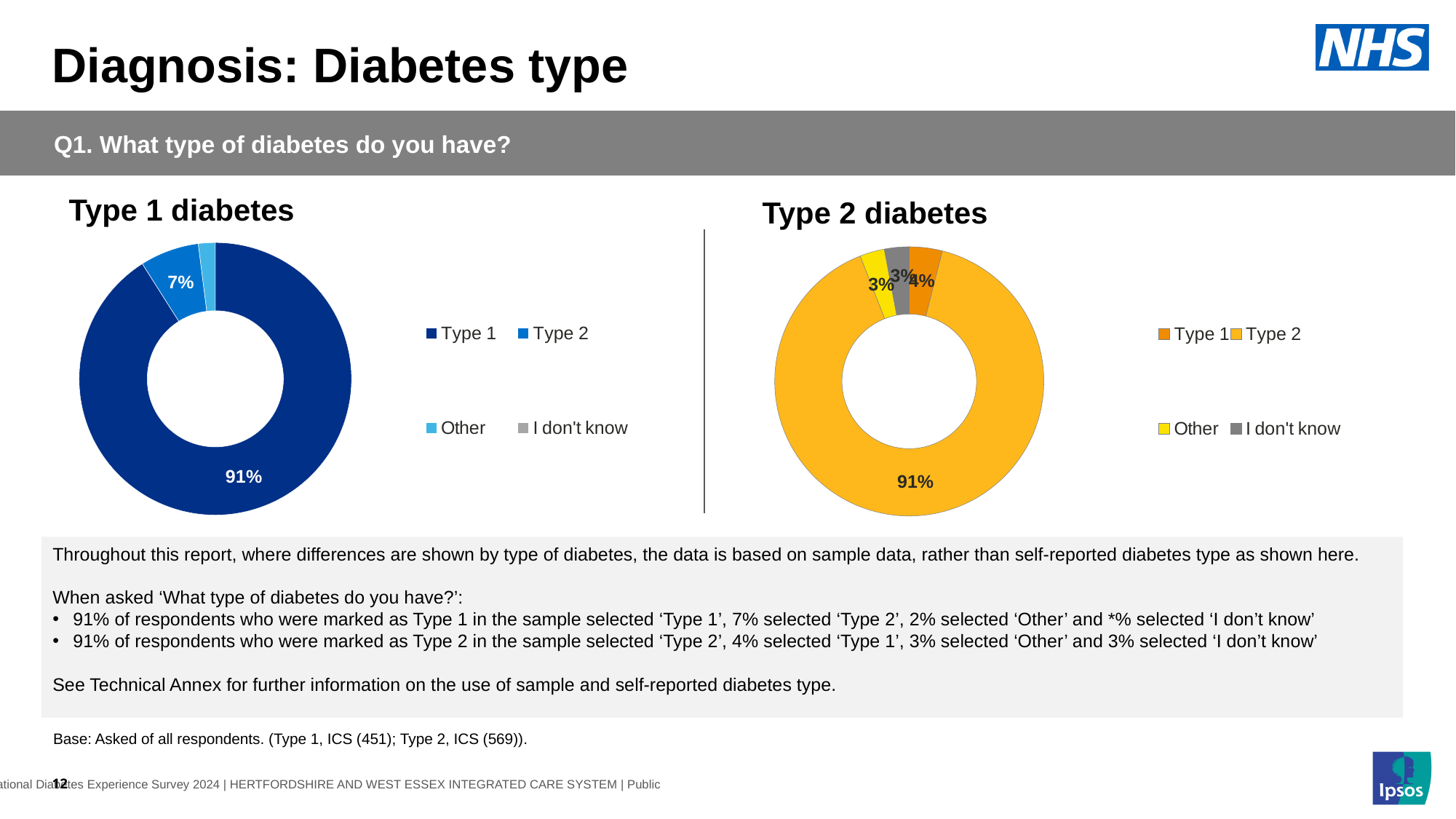
In the Type 1 diabetes chart, which category has the largest share? Type 1 In the Type 1 diabetes chart, what is the difference in percentage points between the 'Type 1' and 'Type 2' slices? 84 percentage points In the Type 2 diabetes chart, what percentage of respondents selected 'Other'? 3% How many categories does the legend of the Type 1 diabetes chart list? 4 In the Type 2 diabetes chart, which is larger: the 'Type 1' slice or the 'Other' slice? Type 1 In the Type 2 diabetes chart, which category has the largest share? Type 2 In the Type 1 diabetes chart, what percentage of respondents selected 'Type 1'? 91% In the Type 2 diabetes chart, what percentage of respondents selected 'Type 1'? 4% In the Type 2 diabetes chart, what colour is the 'Other' slice? Yellow In the Type 1 diabetes chart, what percentage of respondents selected 'Type 2'? 7% In the Type 2 diabetes chart, what percentage of respondents selected 'Type 2'? 91% What kind of chart is used for the Type 2 diabetes data? Donut (pie) chart